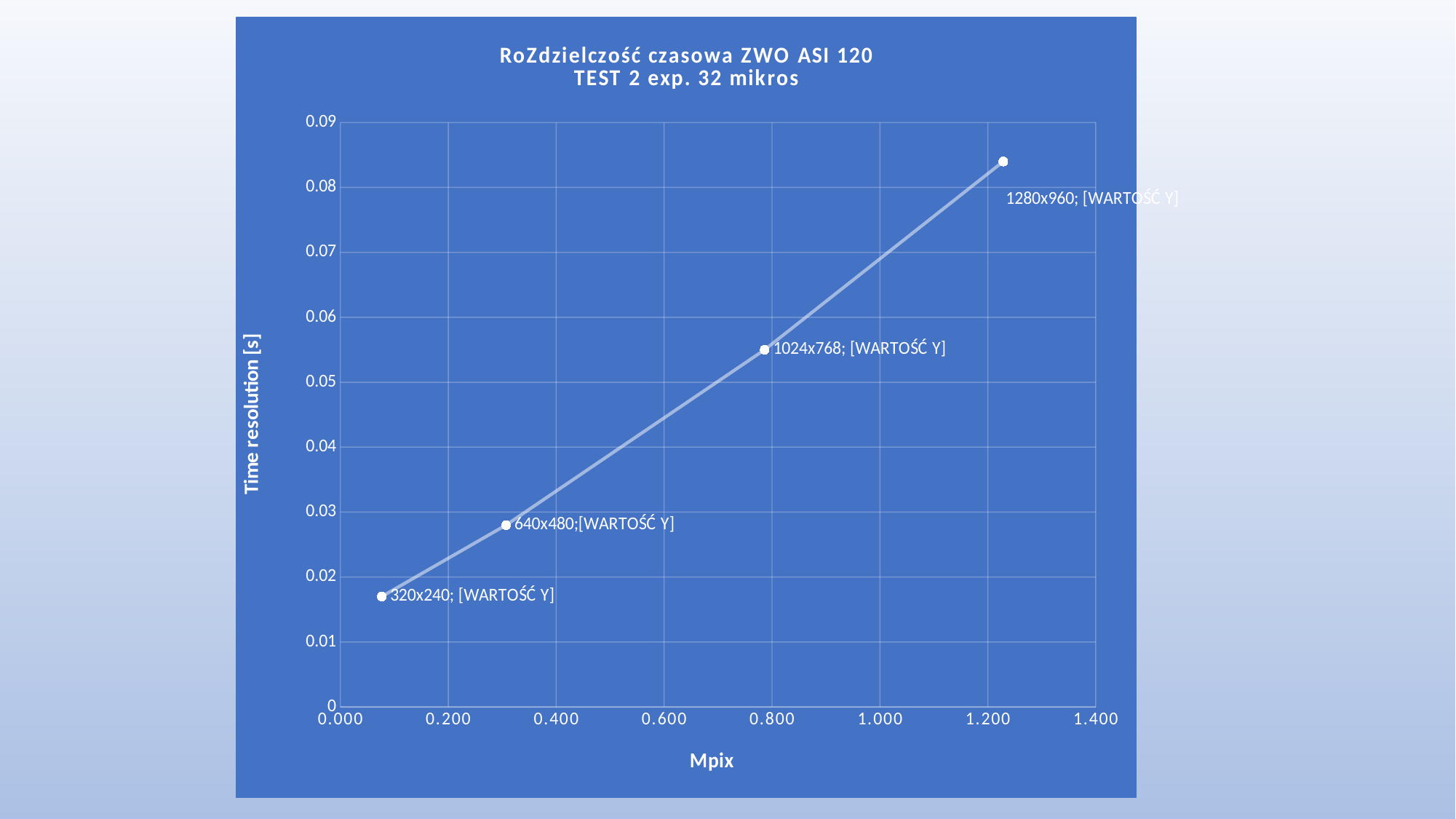
Is the value for 640x480 greater or less than 0.03? less What kind of chart is shown on the slide? line chart Which resolution has the highest time resolution value? 1280x960 Do the values rise or fall as Mpix increases along the x axis? rise Is the value for 1024x768 greater or less than 0.05? greater Is the value for 320x240 greater or less than 0.02? less How many data points are plotted on the chart? 4 What is the label of the x axis? Mpix Which resolution has the lowest time resolution value? 320x240 Which has a larger time resolution value, 640x480 or 1024x768? 1024x768 What is the label of the y axis? Time resolution [s]